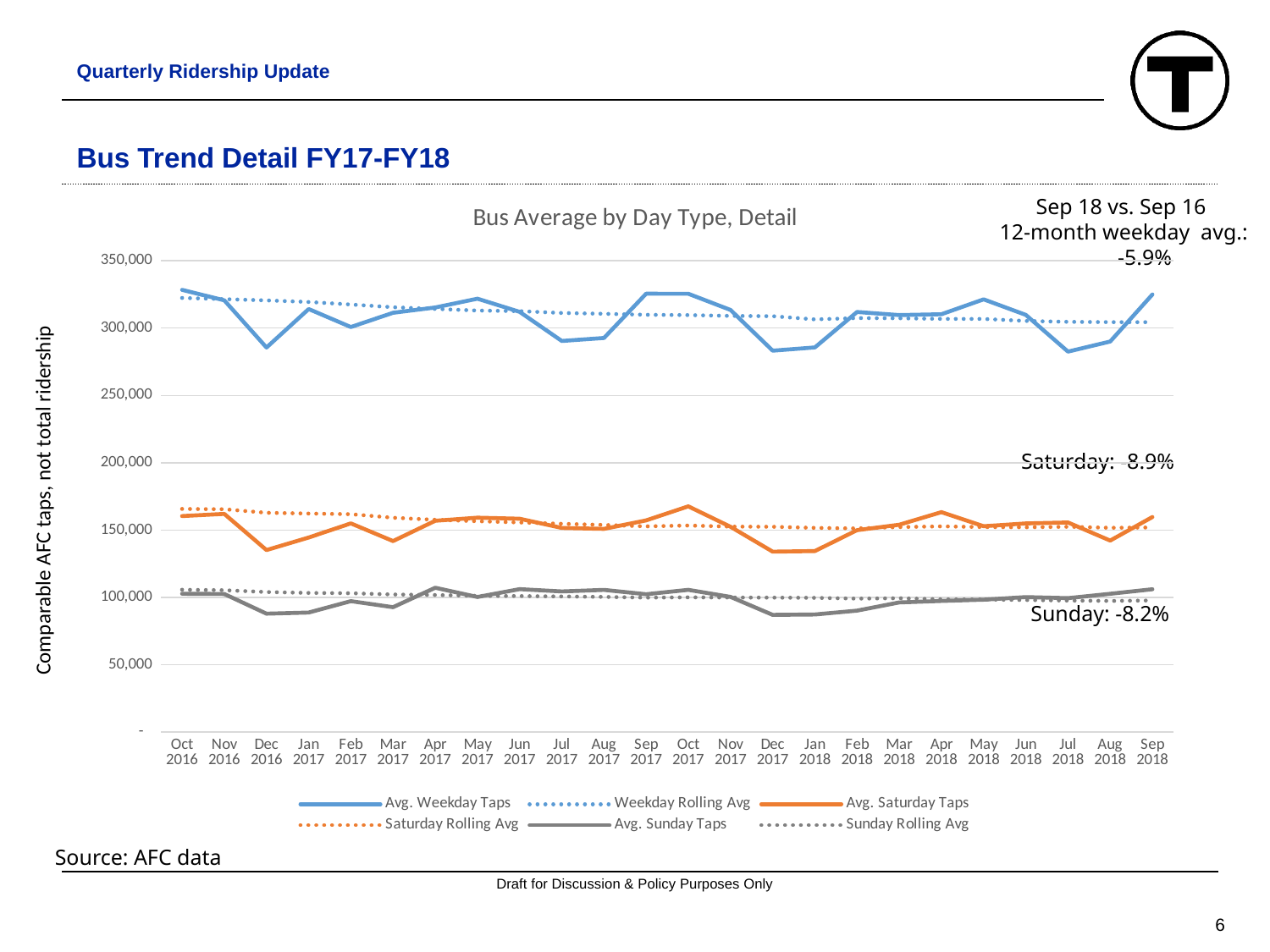
What is the title of the chart? Bus Average by Day Type, Detail Does the Weekday Rolling Avg line rise or fall from Oct 2016 to Sep 2018? Fall What is the label on the vertical axis? Comparable AFC taps, not total ridership According to the annotation, what is the Sep 18 vs. Sep 16 change for Saturday? -8.9% Is the value for Avg. Weekday Taps in Dec 2016 greater or less than 300,000? less According to the annotation, what is the Sep 18 vs. Sep 16 change in the 12-month weekday average? -5.9% What kind of chart is shown on the slide? Line chart How many series does the legend list? 6 Is the value for Avg. Saturday Taps in Dec 2017 greater or less than 150,000? less According to the annotation, what is the Sep 18 vs. Sep 16 change for Sunday? -8.2% How many months are plotted along the x axis? 24